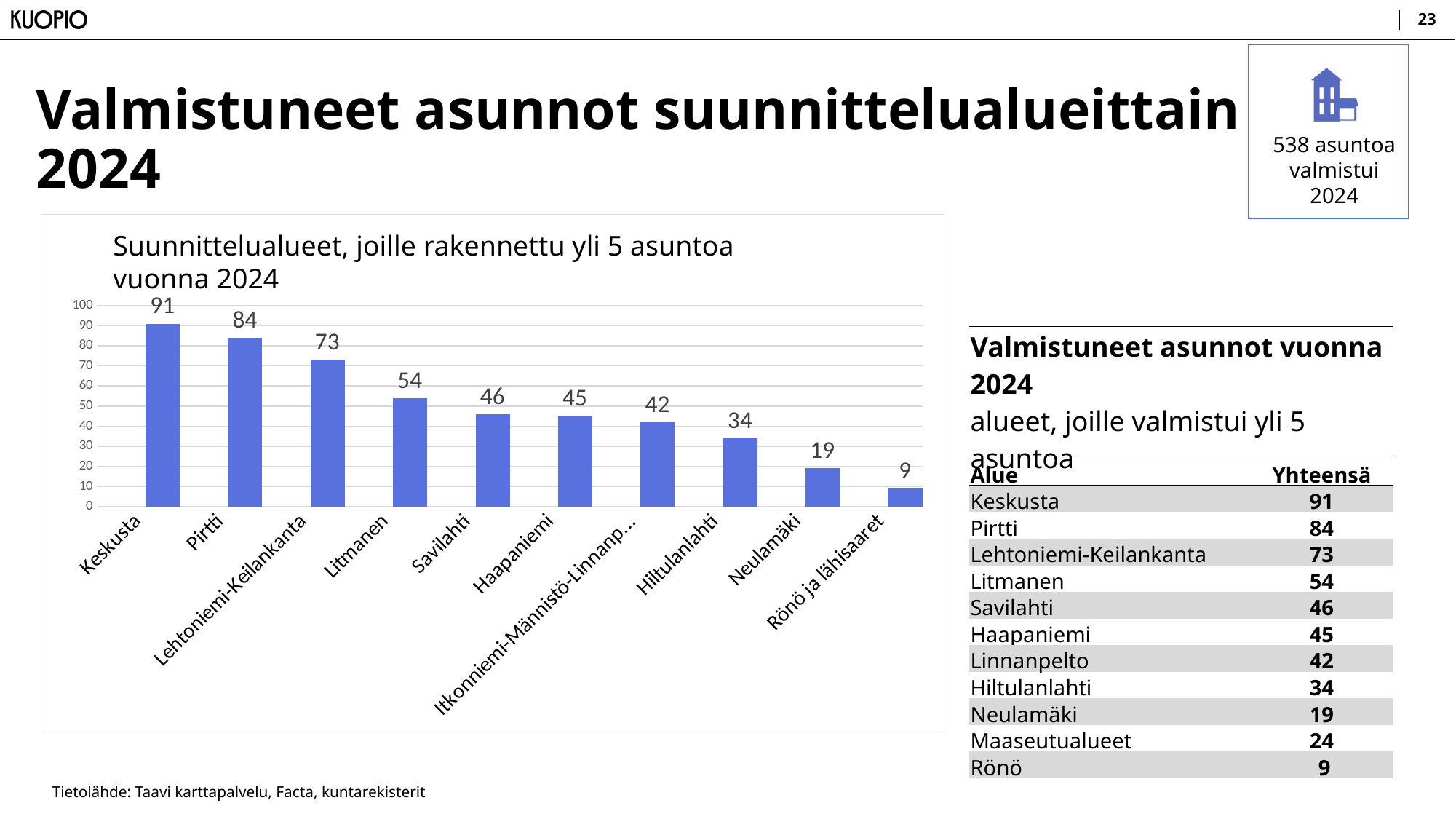
What is the difference between the values for Lehtoniemi-Keilankanta and Hiltulanlahti in the bar chart? 39 Do the values in the bar chart rise or fall from left to right along the x axis? fall Which category has the lowest value in the bar chart? Rönö ja lähisaaret What is the value for Litmanen in the bar chart? 54 What is the difference between the values for Keskusta and Pirtti in the bar chart? 7 What kind of chart is shown on the slide? bar chart What is the value for Keskusta in the bar chart? 91 Which category has the highest value in the bar chart? Keskusta Which is larger in the bar chart, the value for Savilahti or the value for Hiltulanlahti? Savilahti Is the value for Pirtti in the bar chart greater or less than 80? greater How many categories are shown in the bar chart? 10 What is the value for Neulamäki in the bar chart? 19